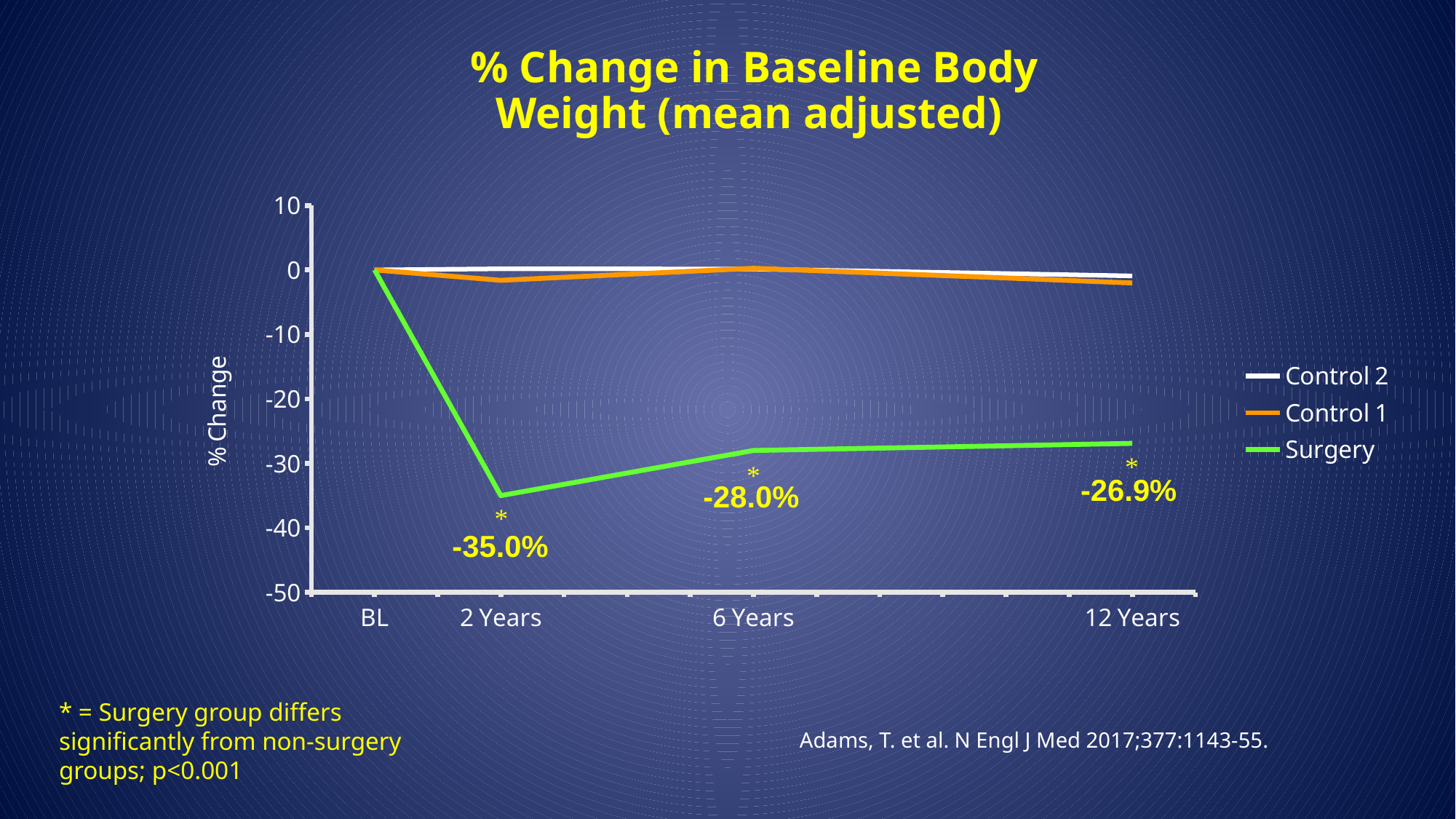
What is the value for the Surgery series at 6 Years? -28.0% What kind of chart is shown on the slide? line chart What is the difference between the Surgery values at 2 Years and 6 Years? 7.0 percentage points What is the value for the Surgery series at 12 Years? -26.9% Is the value for Control 1 at 2 Years greater or less than -10? greater What is the value for the Surgery series at 2 Years? -35.0% How many time points are shown on the x axis? 4 What is the difference between the Surgery values at 6 Years and 12 Years? 1.1 percentage points Which is higher for the Surgery series: the value at 6 Years or at 12 Years? 12 Years How many series does the legend list? 3 At which time point does the Surgery series reach its lowest value? 2 Years Does the Surgery series rise or fall from 2 Years to 12 Years? rise